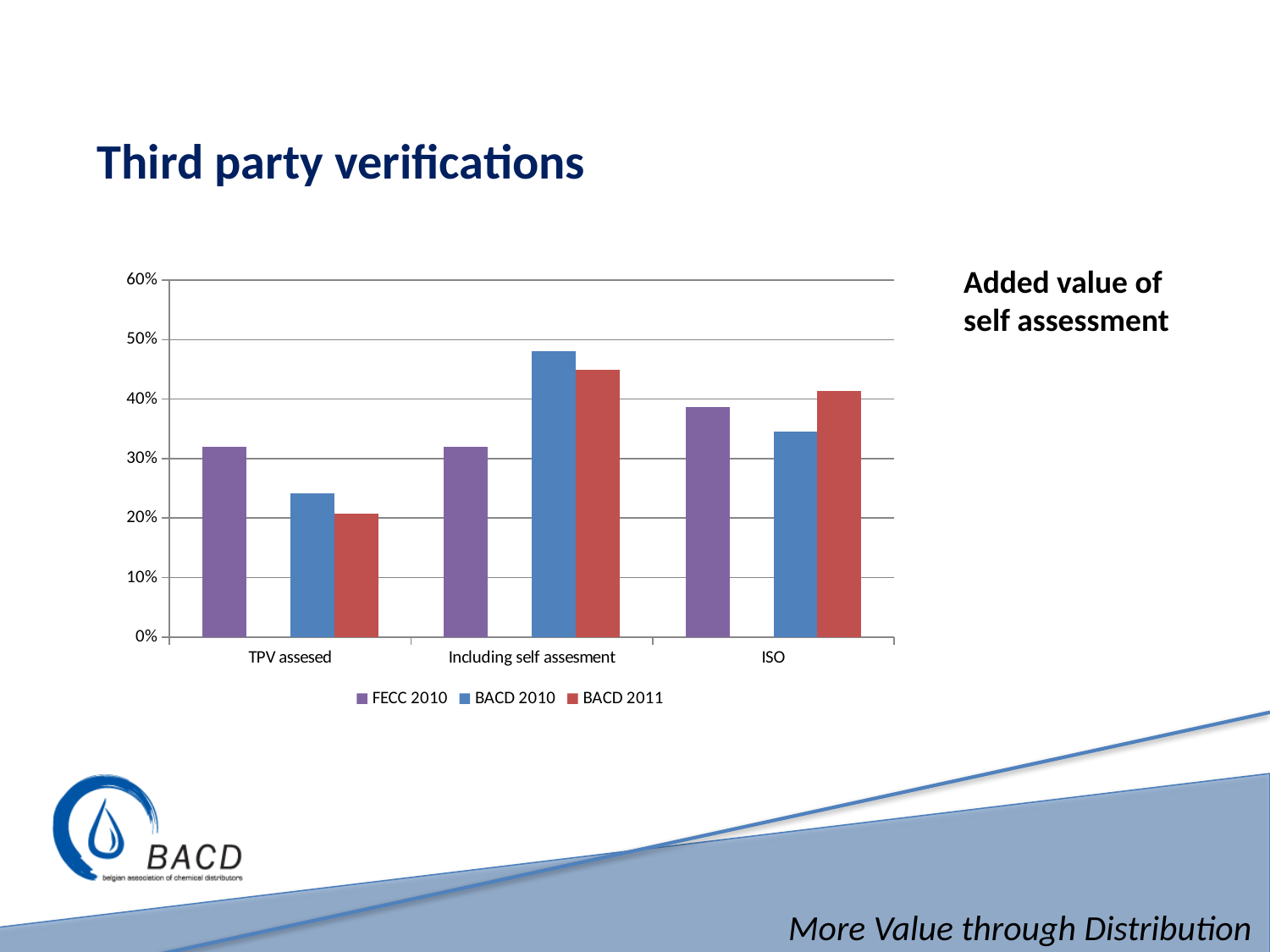
Is the value for BACD 2011 in the TPV assesed category greater or less than 30%? less Is the value for BACD 2010 in the Including self assesment category greater or less than 40%? greater In the TPV assesed category, which is larger: FECC 2010 or BACD 2011? FECC 2010 How many categories are shown on the x axis? 3 Is the value for FECC 2010 in the ISO category greater or less than 30%? greater Which series is shown in red? BACD 2011 Which category has the lowest BACD 2011 value? TPV assesed How many series does the legend list? 3 Which category has the highest BACD 2010 value? Including self assesment In the Including self assesment category, which is larger: FECC 2010 or BACD 2010? BACD 2010 What kind of chart is shown on the slide? bar chart